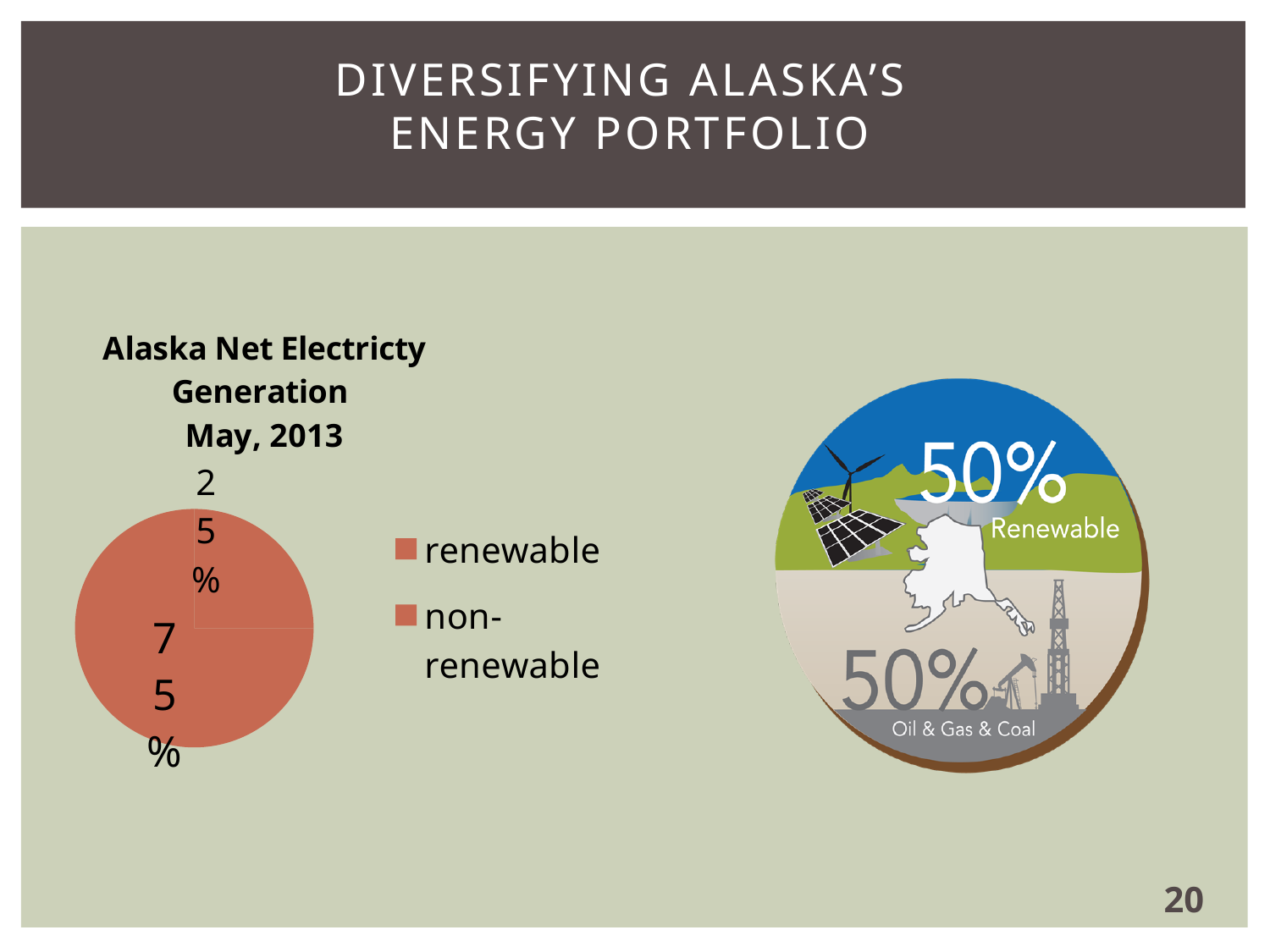
What percentage of Alaska net electricity generation in May 2013 is shown as renewable? 25% What kind of chart is shown on the slide? pie chart How many entries does the pie chart's legend list? 2 By how many percentage points does the non-renewable slice exceed the renewable slice? 50 percentage points Which category has the largest slice of the pie chart? non-renewable Which is larger in the pie chart, renewable or non-renewable? non-renewable What is the title of the pie chart? Alaska Net Electricty Generation May, 2013 Which category has the smallest slice of the pie chart? renewable How many slices does the pie chart have? 2 What are the two legend entries of the pie chart? renewable and non-renewable What percentage of Alaska net electricity generation in May 2013 is shown as non-renewable? 75% What share of the pie does the largest slice represent? 75%